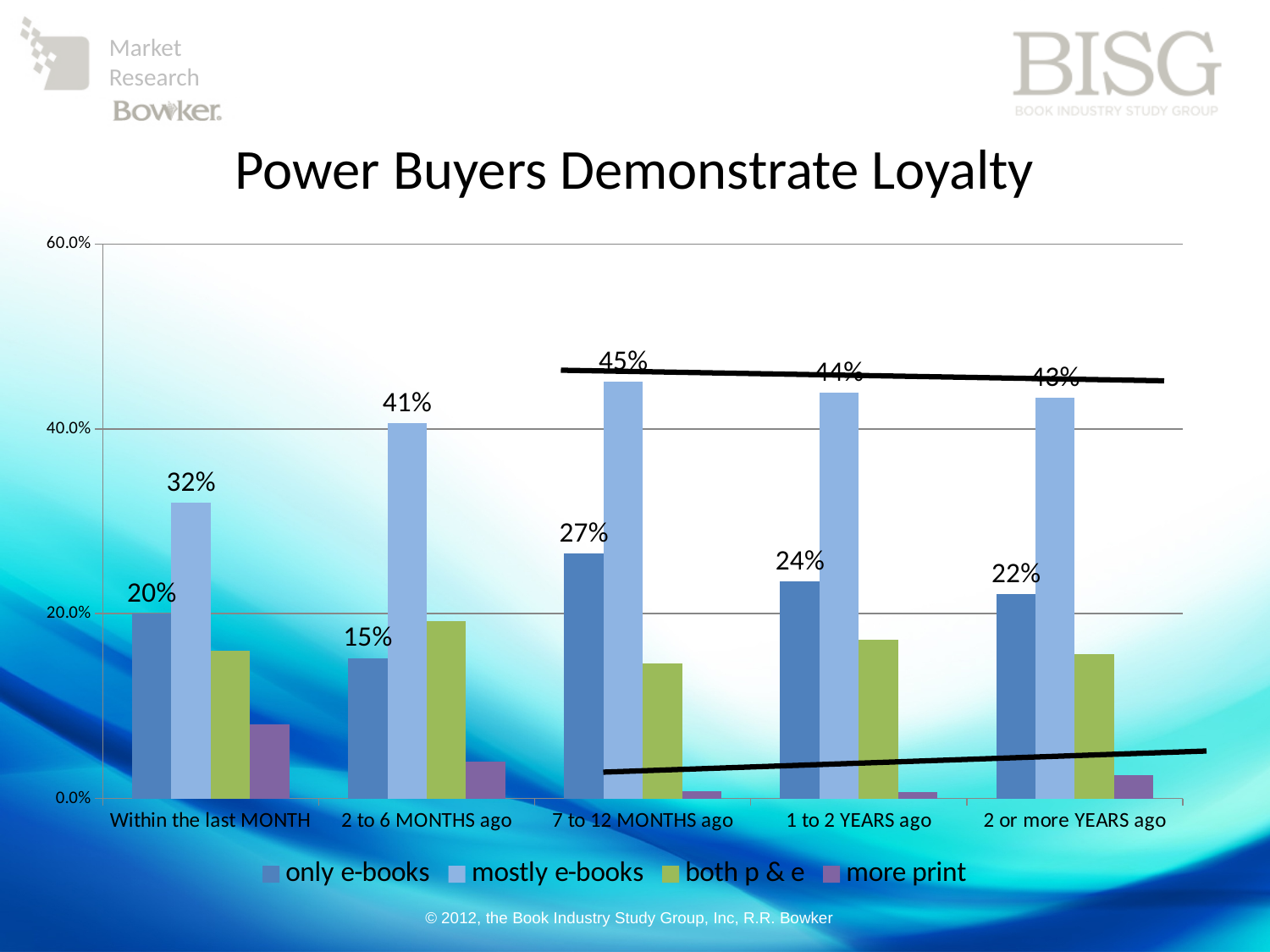
What is the value for 'mostly e-books' in the '2 to 6 MONTHS ago' category? 41% What is the difference between the 'mostly e-books' and 'only e-books' values in the '7 to 12 MONTHS ago' category? 18% How many categories are shown on the x axis? 5 What is the value for 'only e-books' in the 'Within the last MONTH' category? 20% Which category has the highest value for 'only e-books'? 7 to 12 MONTHS ago Which category has the lowest value for 'only e-books'? 2 to 6 MONTHS ago Which is larger in the 'Within the last MONTH' category: 'only e-books' or 'mostly e-books'? mostly e-books What is the title of the chart? Power Buyers Demonstrate Loyalty What is the value for 'mostly e-books' in the '7 to 12 MONTHS ago' category? 45% How many series does the legend list? 4 What type of chart is shown on the slide? bar chart